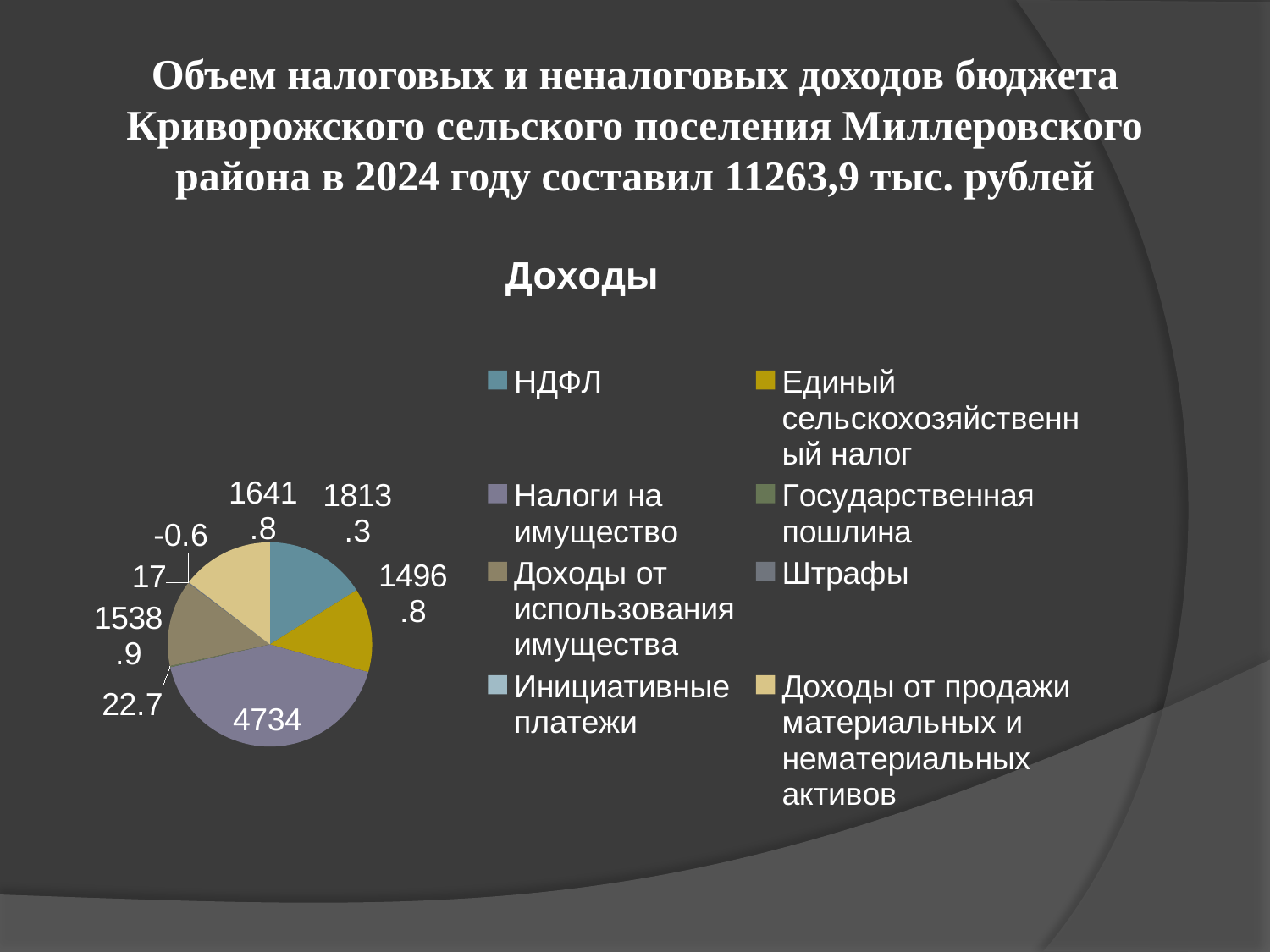
What is the value for НДФЛ? 1813.3 What is the title of the chart? Доходы What type of chart is shown on the slide? pie chart What is the value for Налоги на имущество? 4734 What is the value for Единый сельскохозяйственный налог? 1496.8 What is the difference between the values for Налоги на имущество and НДФЛ? 2920.7 What is the value for Доходы от продажи материальных и нематериальных активов? 1641.8 Which category has the largest slice of the pie? Налоги на имущество What is the value for Доходы от использования имущества? 1538.9 Which is larger, the value for НДФЛ or the value for Единый сельскохозяйственный налог? НДФЛ How many categories does the legend of the pie chart list? 8 Which category has the smallest value in the pie chart? Инициативные платежи